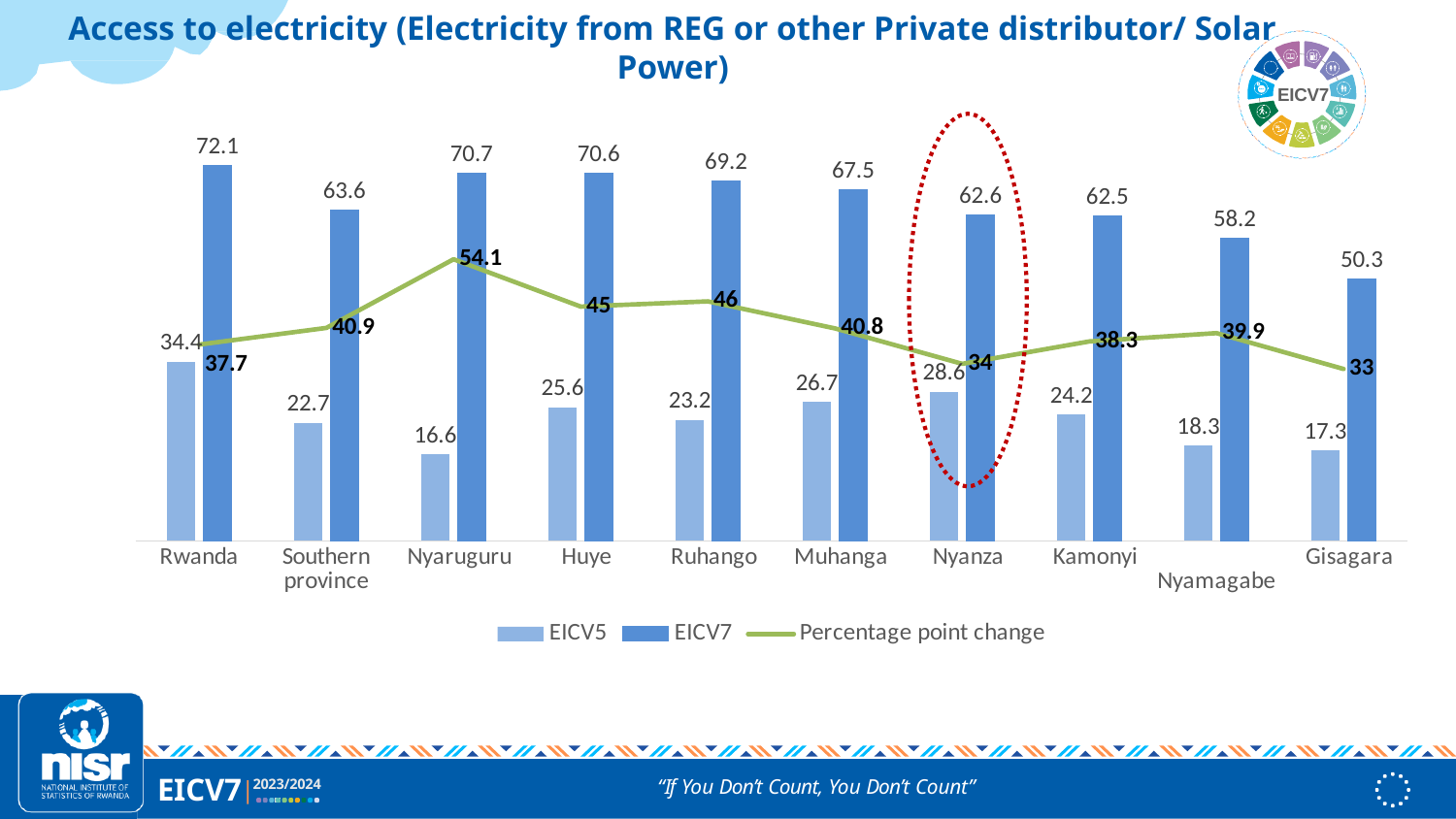
What is the percentage point change for Gisagara? 33 What is the EICV5 value for Nyaruguru? 16.6 Which has the larger EICV5 value, Kamonyi or Nyamagabe? Kamonyi What kind of chart is this? Bar chart with a line What is the difference between the EICV7 and EICV5 values for Rwanda? 37.7 Which category has the lowest EICV5 value? Nyaruguru Which category has the highest EICV7 value? Rwanda What is the EICV7 value for Nyanza? 62.6 Which category has the highest percentage point change? Nyaruguru How many categories are shown on the x axis? 10 How many series does the legend list? 3 Which category is highlighted with a red dotted circle? Nyanza